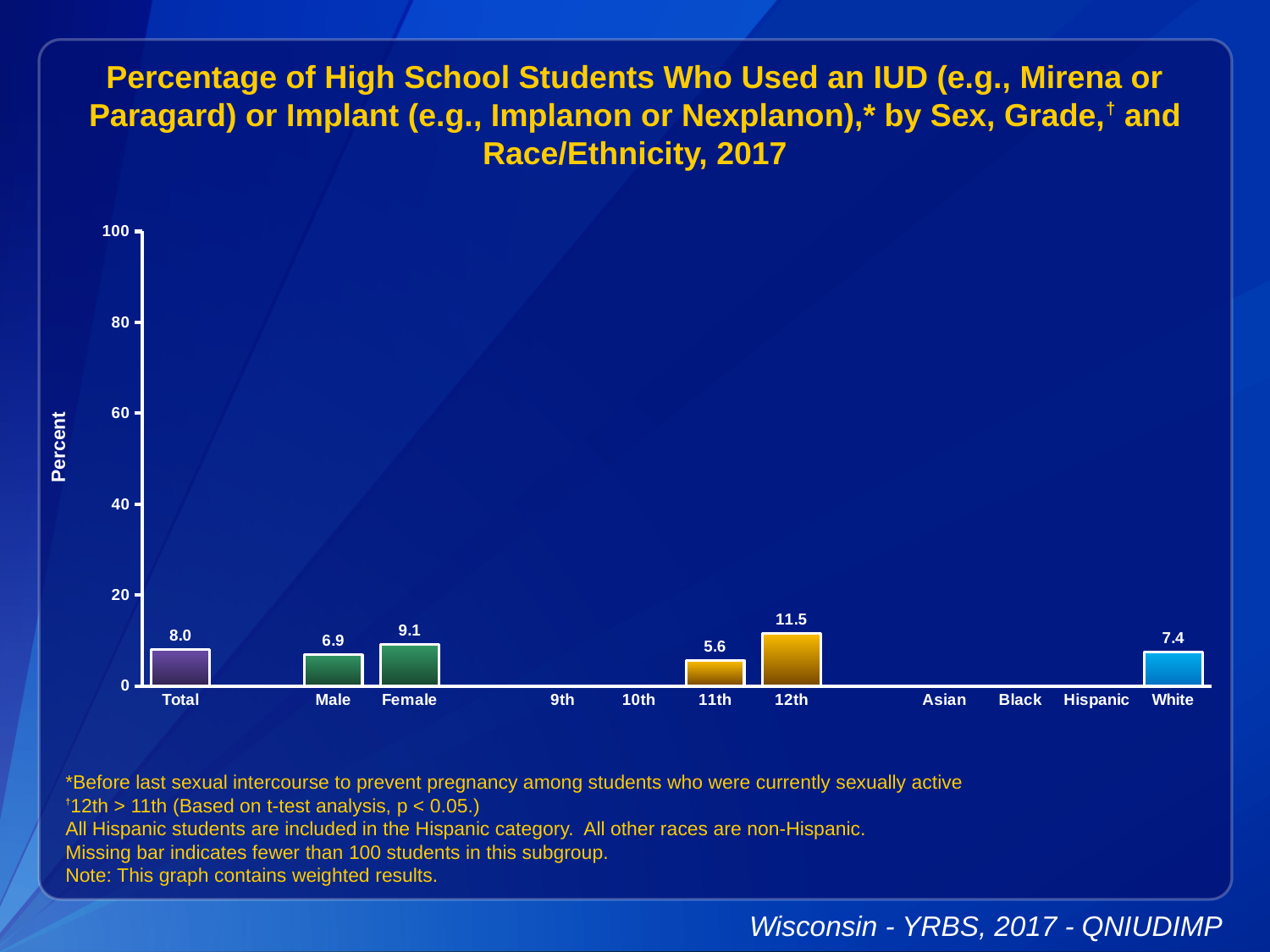
What kind of chart is shown? bar chart What is the label on the y axis? Percent What is the difference between the Female and Male values? 2.2 What is the value for Total? 8.0 What is the value for Female? 9.1 Which category has the highest value? 12th How many categories have a bar plotted? 6 Which category with a plotted bar has the lowest value? 11th Which is larger, the value for 11th or the value for 12th? 12th Is the value for 12th greater or less than 20? less What is the value for White? 7.4 What is the value for 12th grade? 11.5